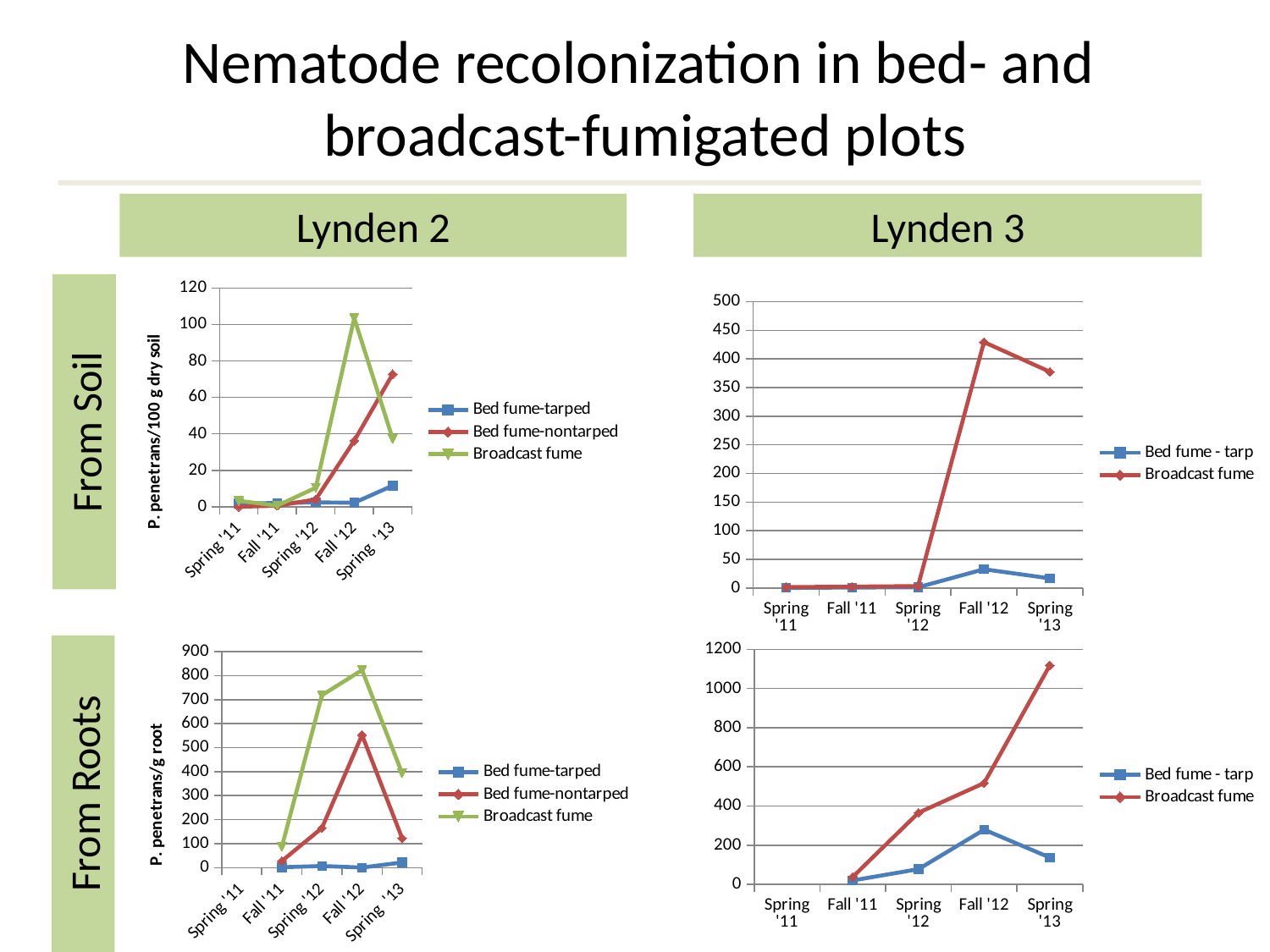
In the Lynden 2 'From Soil' chart (top left), is the Broadcast fume value at Fall '12 greater or less than 80? greater In the Lynden 3 'From Roots' chart (bottom right), which is larger at Spring '13: Broadcast fume or Bed fume - tarp? Broadcast fume In the Lynden 2 'From Roots' chart (bottom left), is the Bed fume-nontarped value at Fall '12 greater or less than 500? greater In the Lynden 2 'From Roots' chart (bottom left), which series has the highest value at Fall '12? Broadcast fume How many series does the legend of the Lynden 3 'From Soil' chart (top right) list? 2 How many series does the legend of the Lynden 2 'From Soil' chart (top left) list? 3 How many time points are shown on the x axis of the Lynden 3 'From Roots' chart (bottom right)? 5 In the Lynden 3 'From Roots' chart (bottom right), is the Broadcast fume value at Spring '13 greater or less than 1000? greater In the Lynden 3 'From Roots' chart (bottom right), does the Broadcast fume series rise or fall from Fall '11 to Spring '13? rise What kind of chart is the Lynden 2 'From Soil' chart (top left)? line chart In the Lynden 2 'From Soil' chart (top left), at which time point does the Broadcast fume series reach its peak? Fall '12